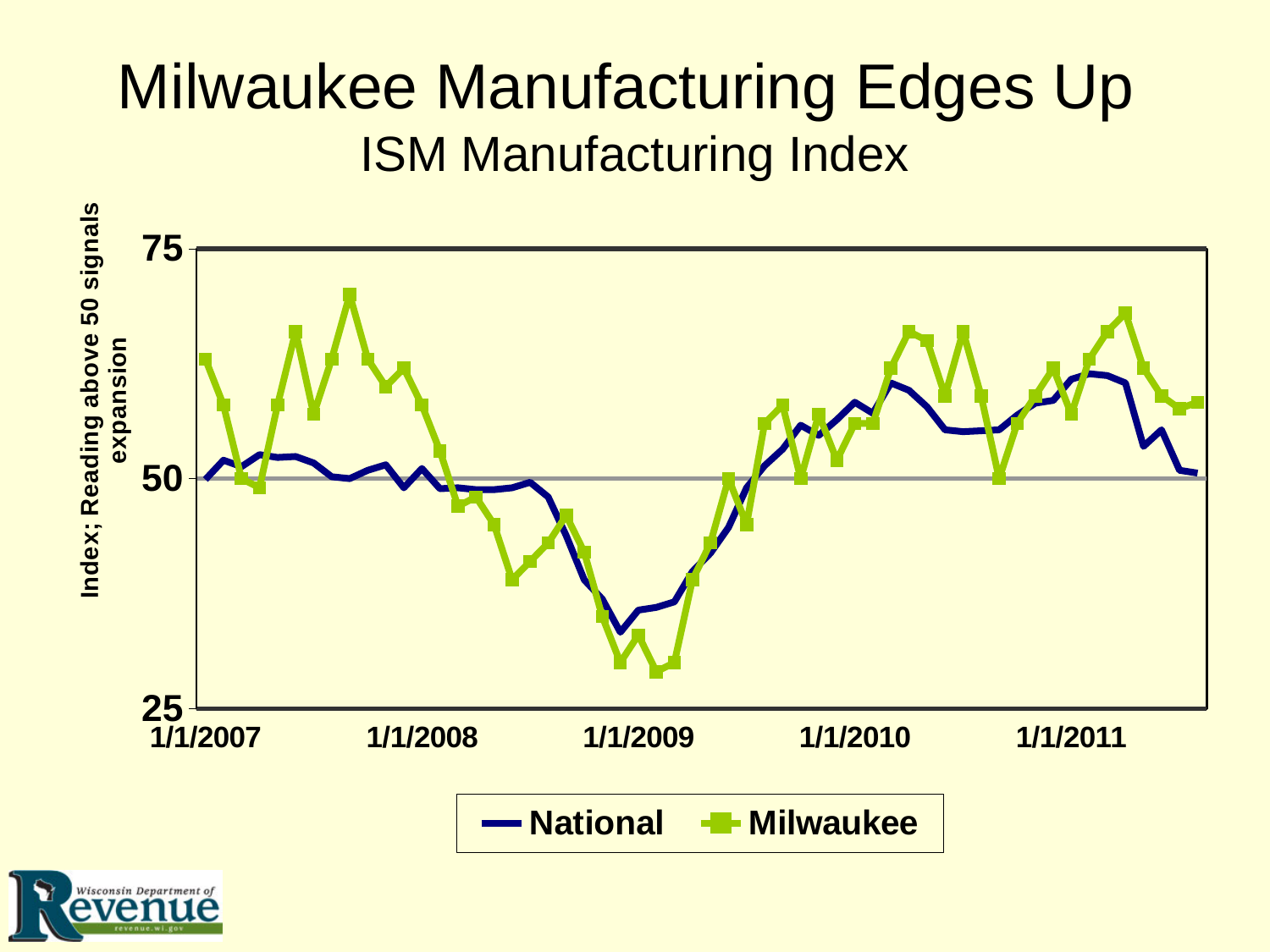
What is the subtitle of the chart below the main title? ISM Manufacturing Index What are the two series named in the legend? National and Milwaukee Does the National series rise or fall between 1/1/2008 and 1/1/2009? Fall Is the National value at 1/1/2009 greater or less than 50? less Is the Milwaukee value at 1/1/2007 greater or less than 50? greater Which series reaches the highest value anywhere on the chart? Milwaukee At 1/1/2007, which series has the higher value, National or Milwaukee? Milwaukee Is the Milwaukee value at 1/1/2009 greater or less than 50? less What kind of chart is shown on the slide? Line chart At 1/1/2009, which series has the lower value, National or Milwaukee? Milwaukee How many series does the legend list? 2